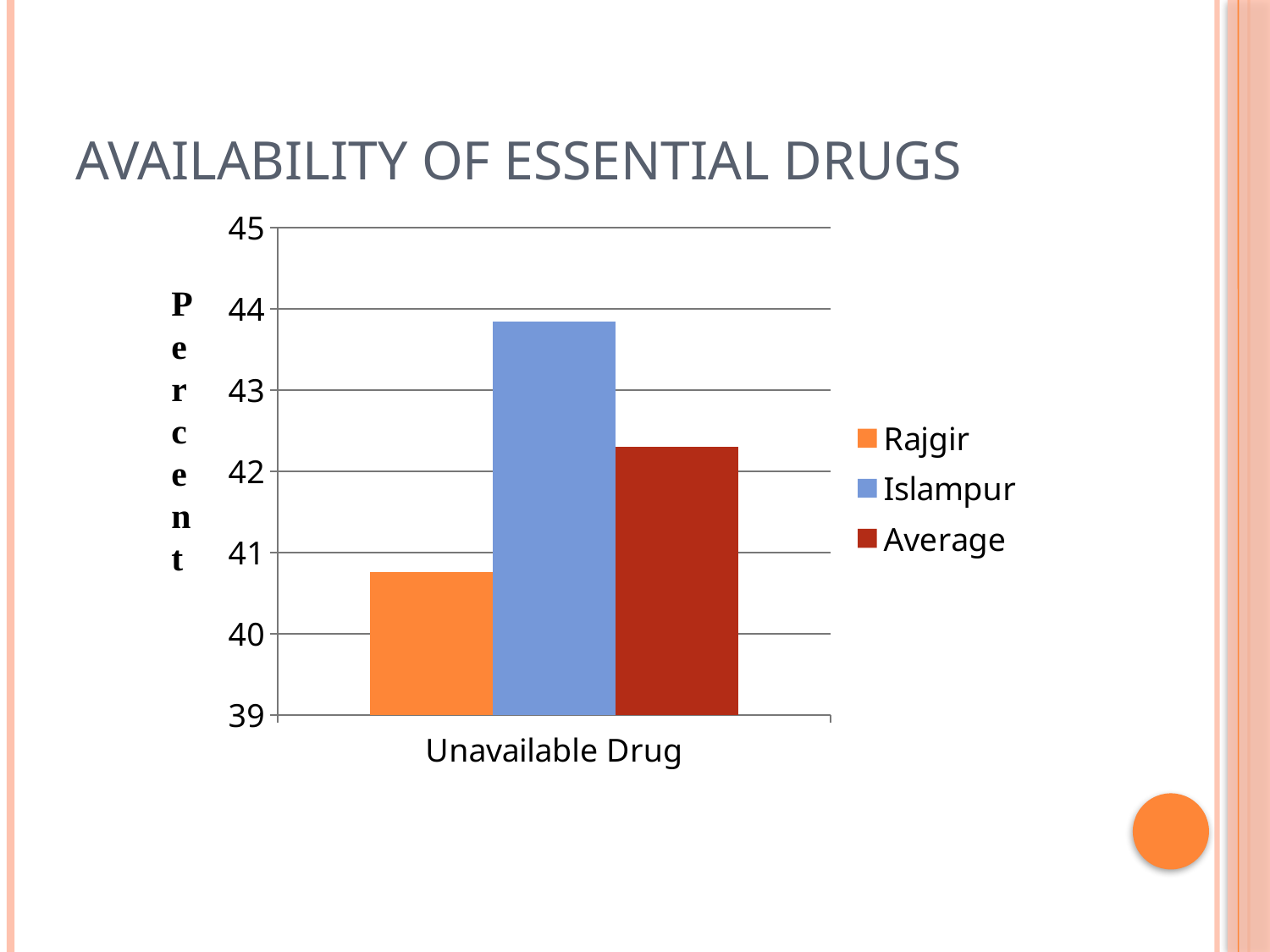
How many categories are shown on the x axis? 1 What is the label of the category on the x axis? Unavailable Drug Is the value for Rajgir greater or less than 41? less How many series does the legend list? 3 Which series has the highest value for Unavailable Drug? Islampur What is the title of the slide containing the chart? AVAILABILITY OF ESSENTIAL DRUGS Which is larger, the value for Rajgir or the value for Average? Average Is the value for Islampur greater or less than 43? greater What kind of chart is shown on the slide? bar chart Which is larger, the value for Islampur or the value for Average? Islampur Which series has the lowest value for Unavailable Drug? Rajgir Is the value for Average greater or less than 42? greater